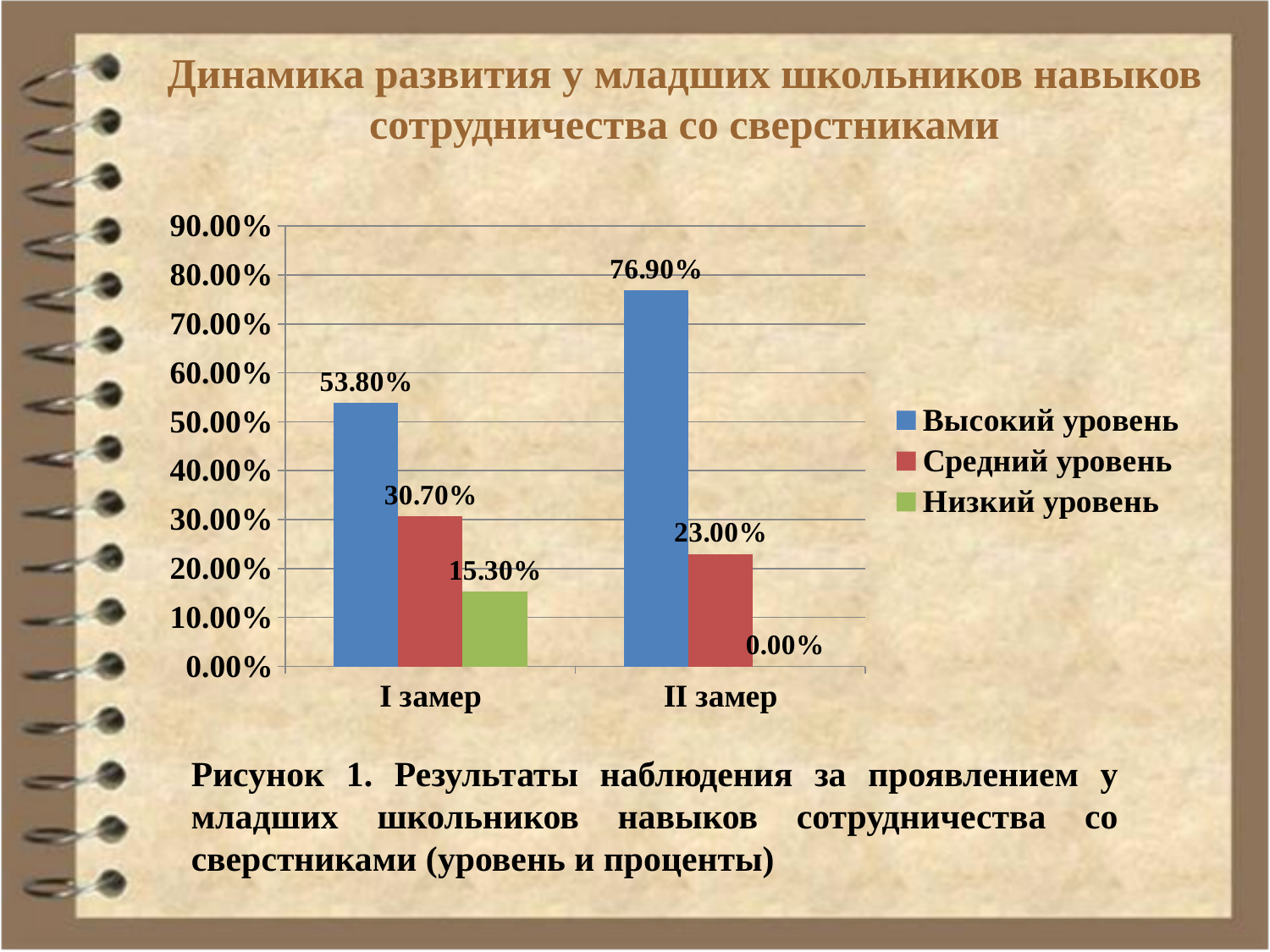
What is the value for Средний уровень in II замер? 23.00% What is the difference between the Высокий уровень values in II замер and I замер? 23.10% Does the value for Высокий уровень rise or fall from I замер to II замер? Rise Which is larger: Средний уровень in I замер or Средний уровень in II замер? Средний уровень in I замер How many series does the legend list? 3 Which series has the highest value in II замер? Высокий уровень What kind of chart is shown on the slide? Bar chart How many categories are shown on the x axis? 2 What is the value for Высокий уровень in I замер? 53.80% What is the value for Низкий уровень in I замер? 15.30% Which series has the lowest value in I замер? Низкий уровень What is the value for Низкий уровень in II замер? 0.00%